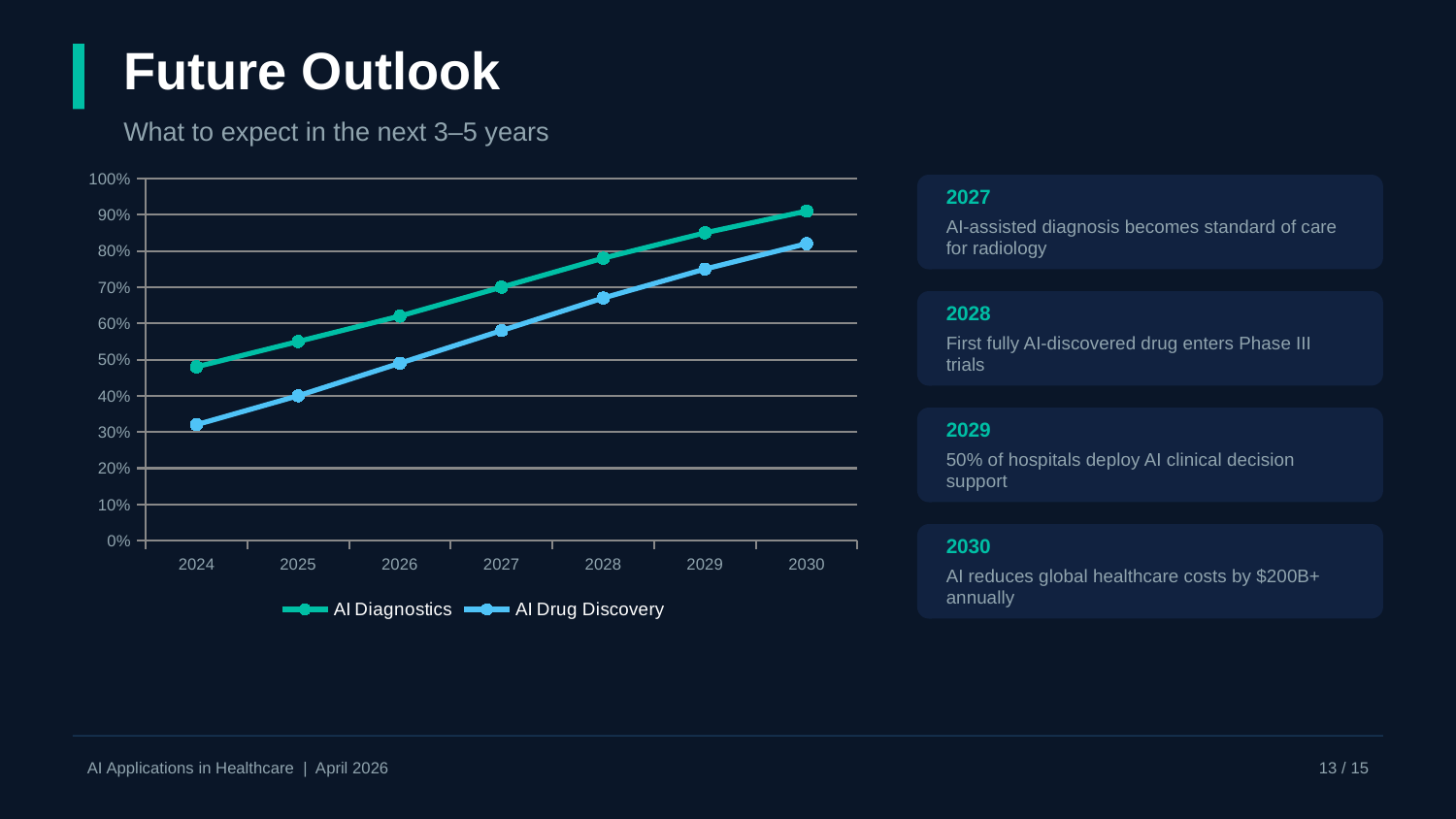
How many years are plotted along the x axis of the chart? 7 Which two series are named in the chart legend? AI Diagnostics and AI Drug Discovery Is the value for AI Diagnostics in 2030 greater or less than 80%? greater Is the value for AI Drug Discovery in 2030 greater or less than 70%? greater In which year is the AI Diagnostics value highest? 2030 In 2024, which series has the larger value, AI Diagnostics or AI Drug Discovery? AI Diagnostics Is the value for AI Drug Discovery in 2024 greater or less than 40%? less How many series does the chart legend list? 2 In which year is the AI Drug Discovery value lowest? 2024 What kind of chart is shown on the slide? line chart Do the values for AI Diagnostics rise or fall from 2024 to 2030? rise